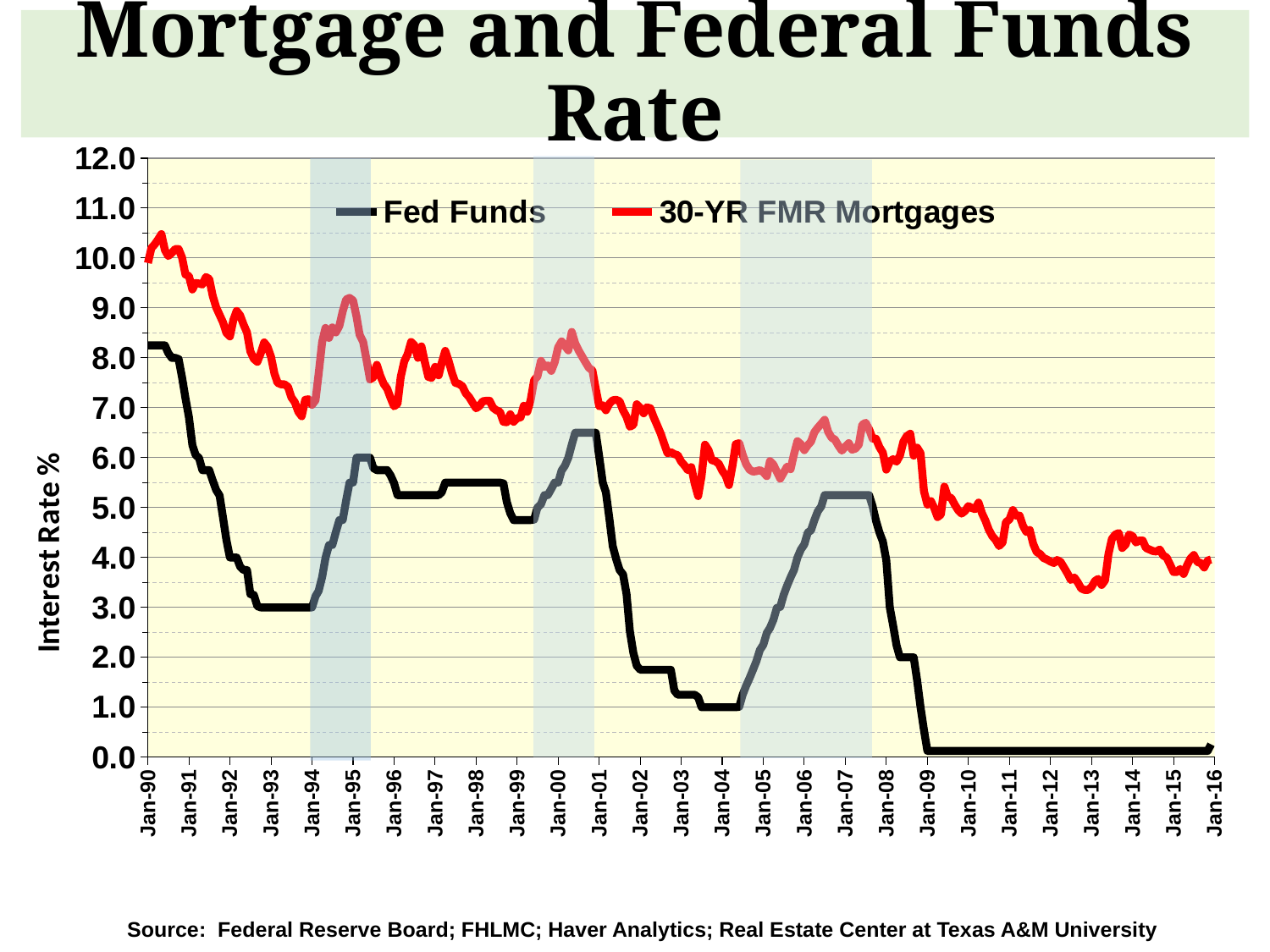
What kind of chart is shown on the slide? line chart Is the Fed Funds value at Jan-90 greater or less than 7.0? greater Overall, does the 30-YR FMR Mortgages rate rise or fall from Jan-90 to Jan-16? fall Is the 30-YR FMR Mortgages value at Jan-90 greater or less than 9.0? greater Is the 30-YR FMR Mortgages value at Jan-13 greater or less than 4.0? less Does the Fed Funds rate rise or fall between Jan-07 and Jan-09? fall How many series does the legend list? 2 Which series has the higher value at Jan-10, Fed Funds or 30-YR FMR Mortgages? 30-YR FMR Mortgages What is the label on the vertical axis? Interest Rate % What are the two series named in the legend? Fed Funds and 30-YR FMR Mortgages